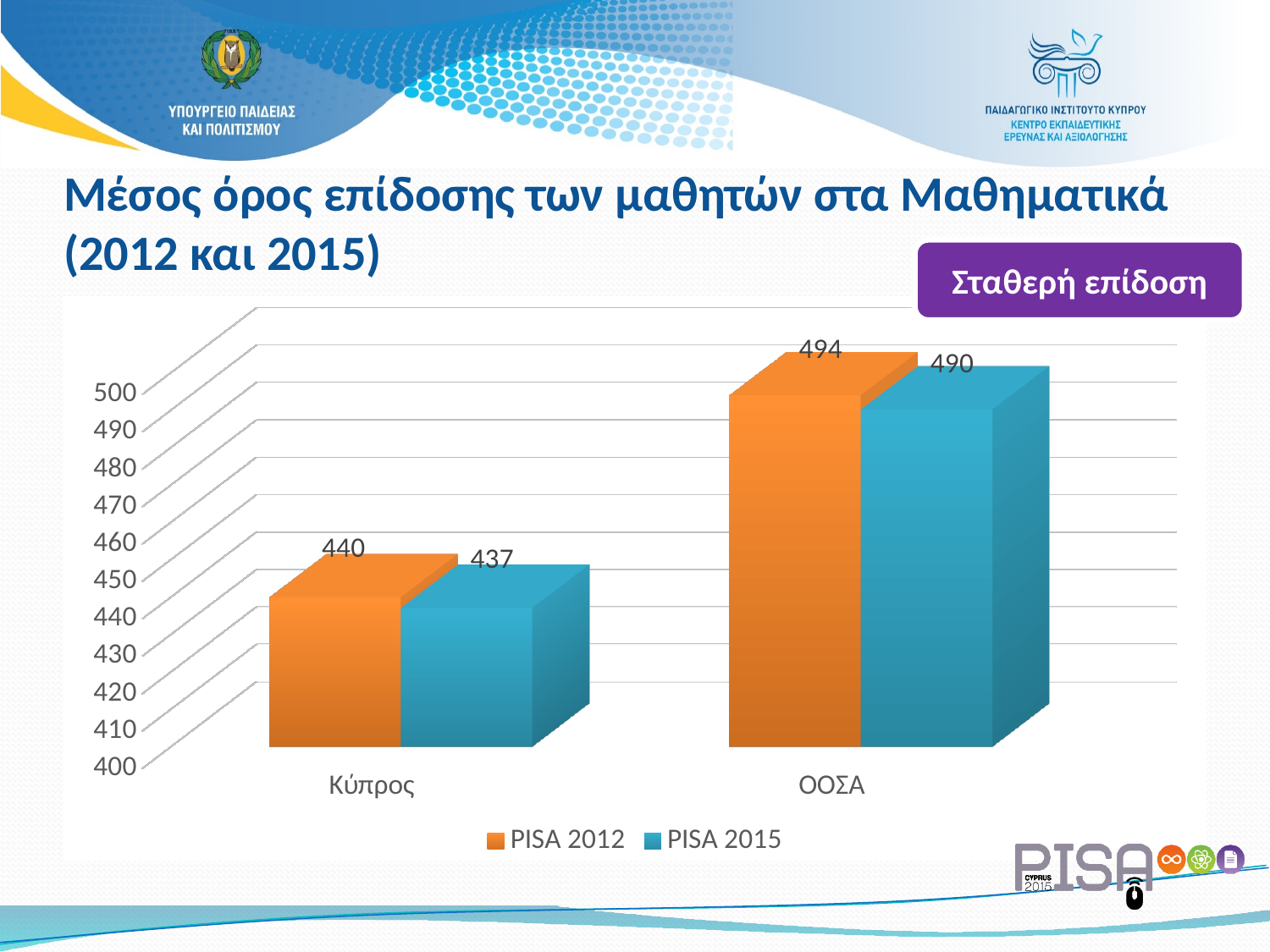
Which category has the lowest PISA 2015 value? Κύπρος How many categories are shown on the x axis? 2 What is the PISA 2015 value for Κύπρος? 437 What is the difference between the ΟΟΣΑ and Κύπρος values for PISA 2015? 53 How many series does the legend list? 2 Which category has the highest PISA 2012 value? ΟΟΣΑ What kind of chart is shown on the slide? Bar chart What is the difference between the PISA 2012 and PISA 2015 values for ΟΟΣΑ? 4 What is the PISA 2012 value for ΟΟΣΑ? 494 What is the PISA 2012 value for Κύπρος? 440 What is the PISA 2015 value for ΟΟΣΑ? 490 Which is larger: the PISA 2012 value for Κύπρος or the PISA 2015 value for Κύπρος? PISA 2012